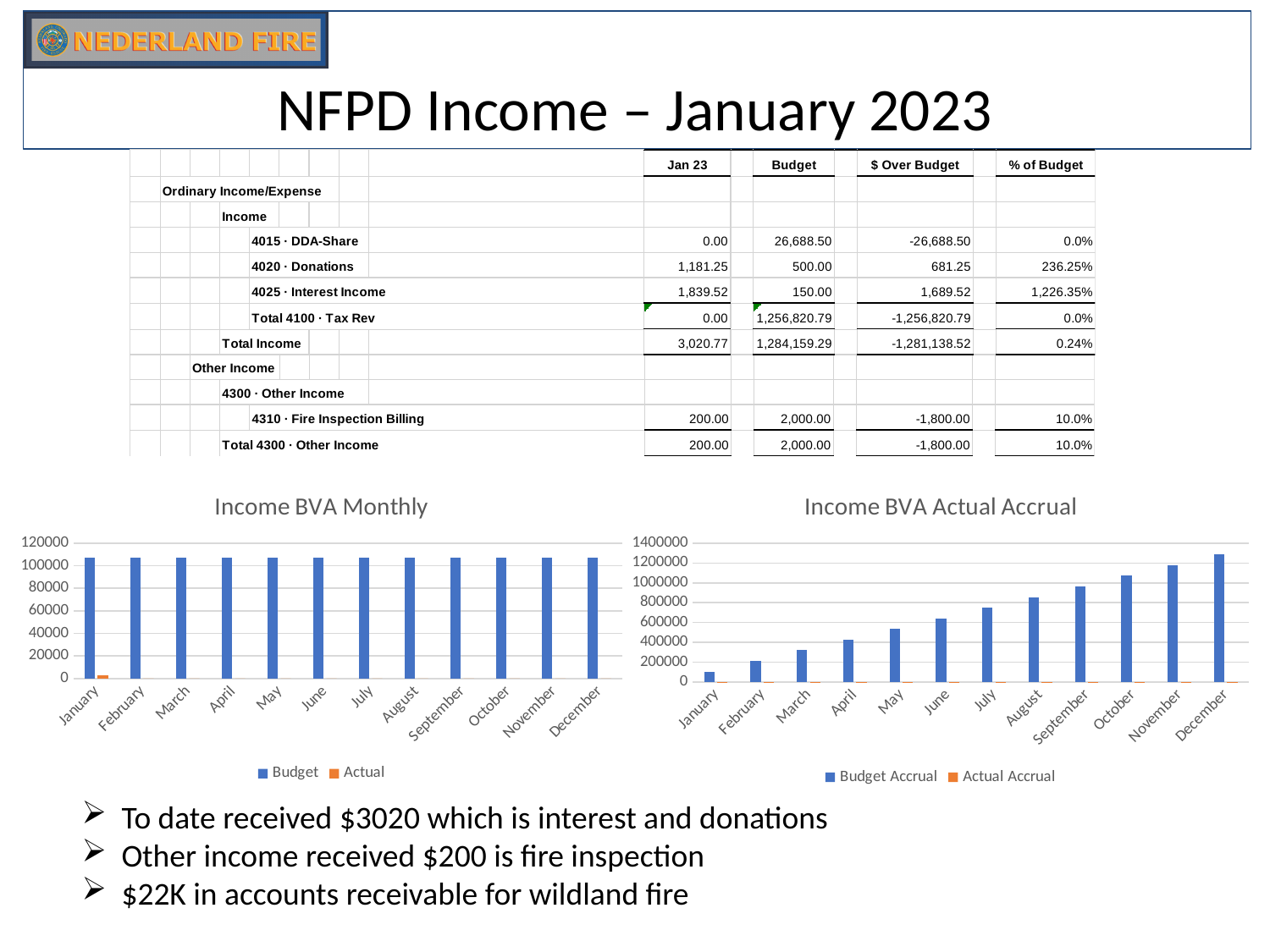
In the "Income BVA Monthly" chart, which is larger for January, Budget or Actual? Budget In the "Income BVA Actual Accrual" chart, which month has the highest Budget Accrual value? December What kind of chart is the "Income BVA Monthly" chart? bar chart In the "Income BVA Actual Accrual" chart, is the Budget Accrual value for December greater or less than 1200000? greater In the "Income BVA Actual Accrual" chart, which month has the lowest Budget Accrual value? January In the "Income BVA Actual Accrual" chart, do the Budget Accrual values rise or fall from January to December? rise In the "Income BVA Monthly" chart, is the Budget value for January greater or less than 100000? greater What are the two series named in the legend of the "Income BVA Actual Accrual" chart? Budget Accrual and Actual Accrual How many months are shown on the x axis of the "Income BVA Actual Accrual" chart? 12 How many series does the legend of the "Income BVA Monthly" chart list? 2 In the "Income BVA Actual Accrual" chart, is the Budget Accrual value for June greater or less than 800000? less